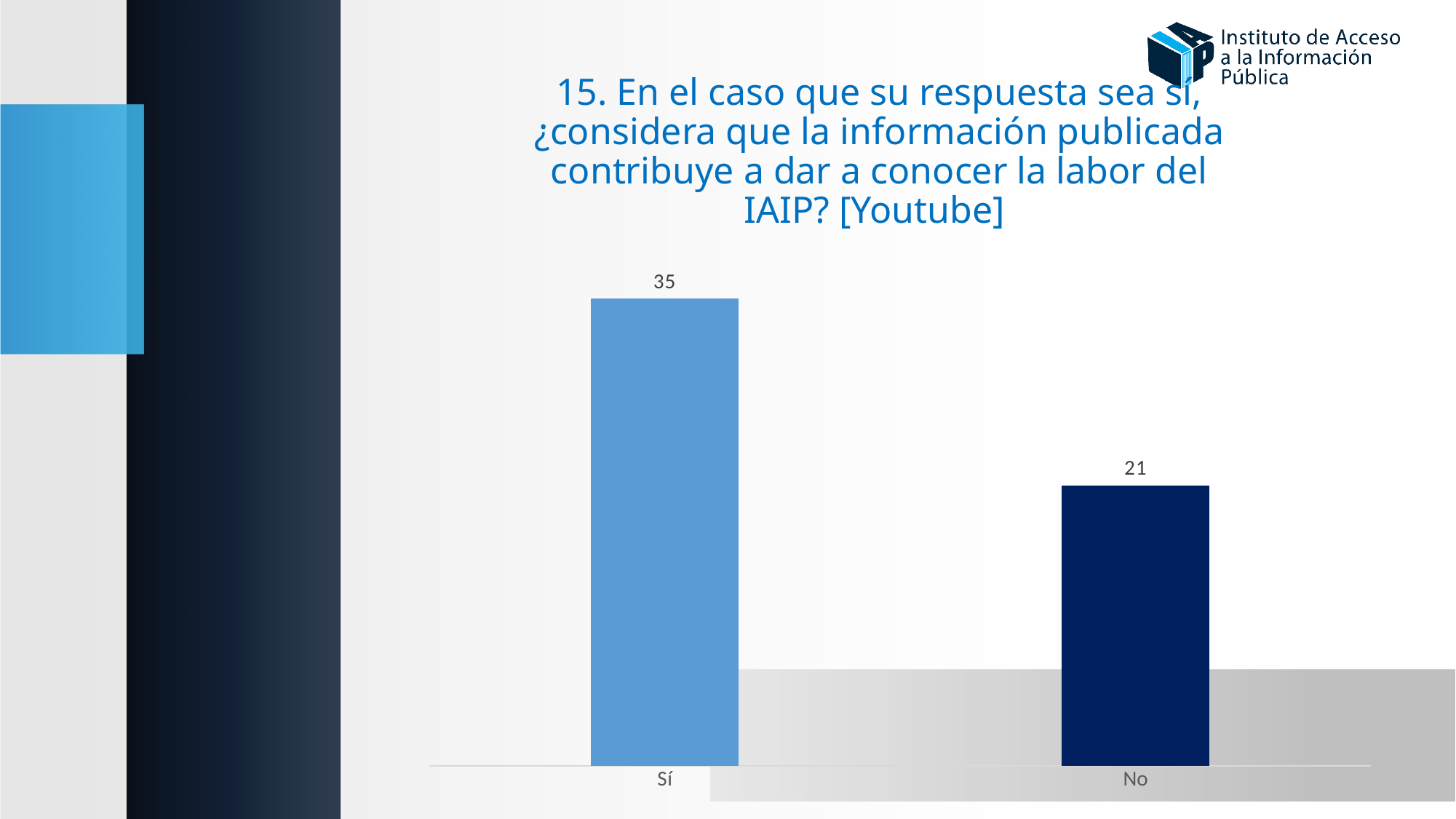
Do the values rise or fall from Sí to No along the x axis? Fall How many categories are shown in the chart? 2 What colour is the bar for No? Dark navy blue What is the value for Sí? 35 What kind of chart is shown on the slide? Bar chart What is the total of the values for Sí and No? 56 Which is larger, the value for Sí or the value for No? Sí Which category has the highest value? Sí What is the value for No? 21 Which platform is named in brackets in the chart title? Youtube Which category has the lowest value? No What is the difference between the values for Sí and No? 14